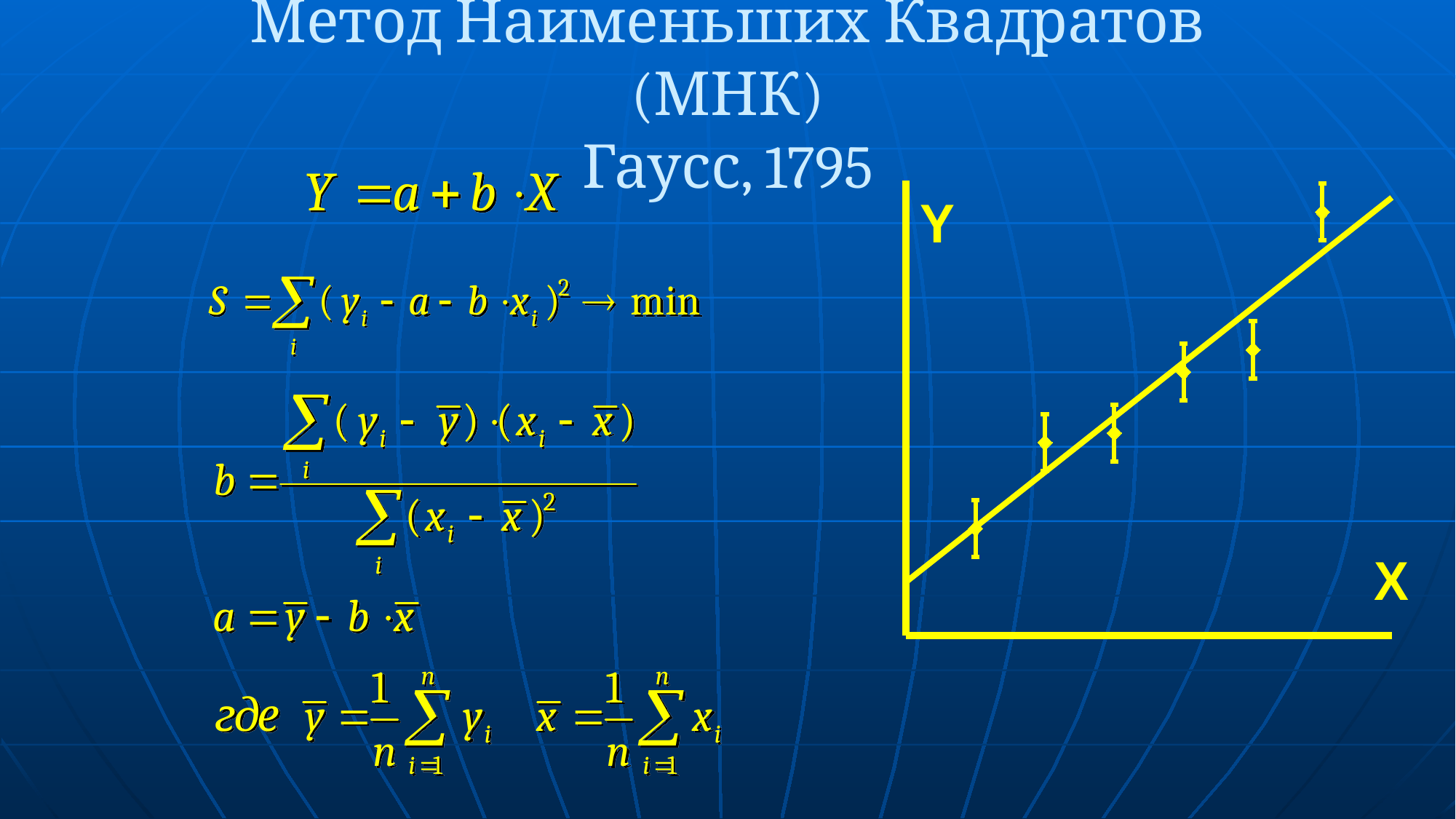
Does the fitted line on the chart slope upward or downward from left to right? Upward How many data points with error bars are plotted on the chart? 6 What is the label of the horizontal axis of the chart? X What is the label of the vertical axis of the chart? Y What kind of chart is shown on the right side of the slide? A scatter plot with a fitted straight line Do the plotted points rise or fall as X increases? Rise